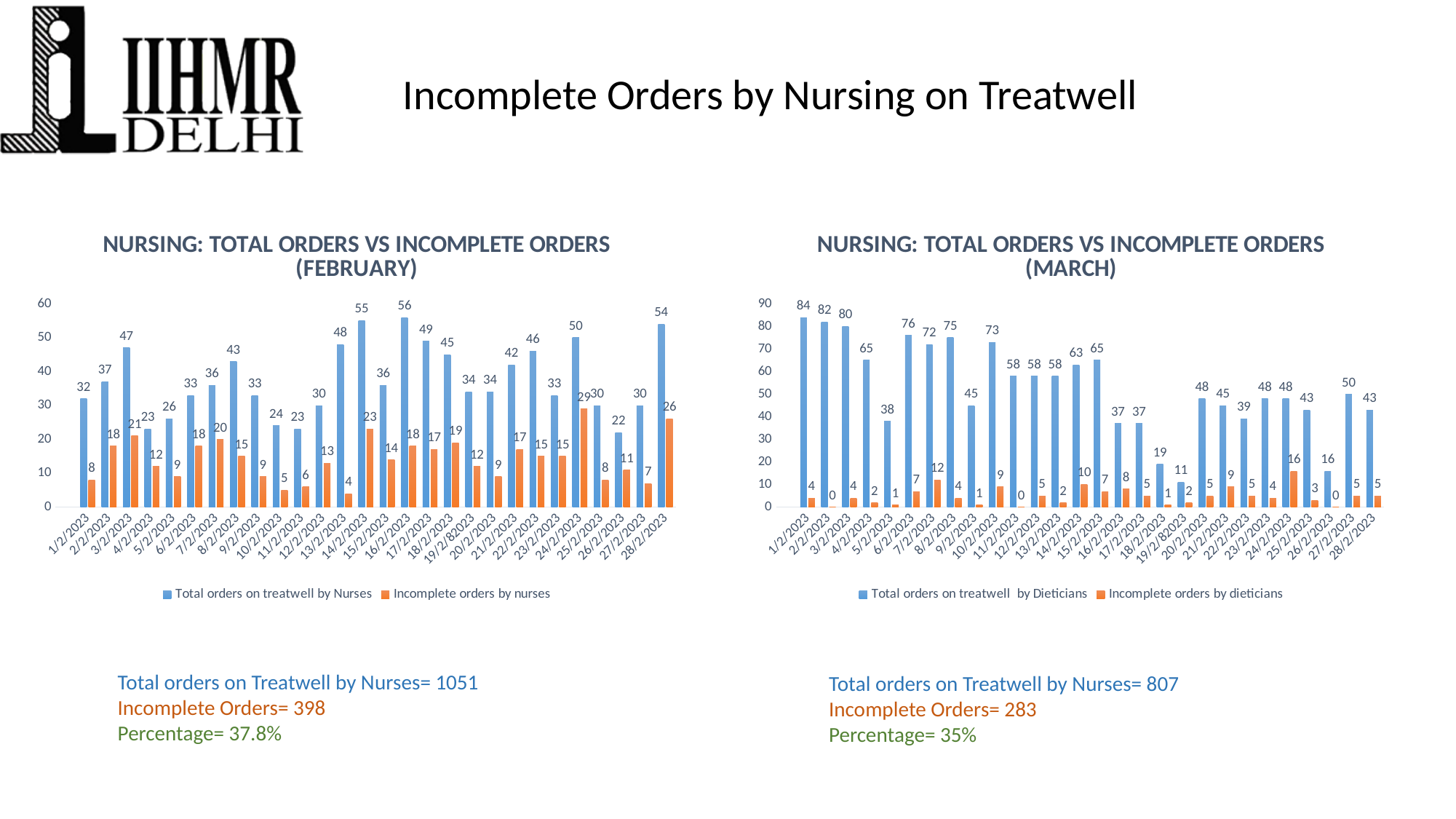
In the March chart, what is the value of the blue series for 1/2/2023? 84 In the February chart, what is the value of Incomplete orders by nurses for 24/2/2023? 29 How many dates are shown on the x axis of the March chart? 28 In the February chart, on which date is Total orders on treatwell by Nurses lowest? 26/2/2023 In the March chart, on which date is the orange series (incomplete orders) highest? 24/2/2023 In the March chart, which is larger: the blue value for 6/2/2023 or the blue value for 5/2/2023? 6/2/2023 In the February chart, what is the difference between total orders and incomplete orders on 14/2/2023? 32 In the February chart, on which date is Total orders on treatwell by Nurses highest? 16/2/2023 In the March chart, what is the value of the orange series for 7/2/2023? 12 How many series does the legend of the February chart list? 2 What type of chart is the February chart? Bar chart In the February chart, what is the value of Total orders on treatwell by Nurses for 16/2/2023? 56